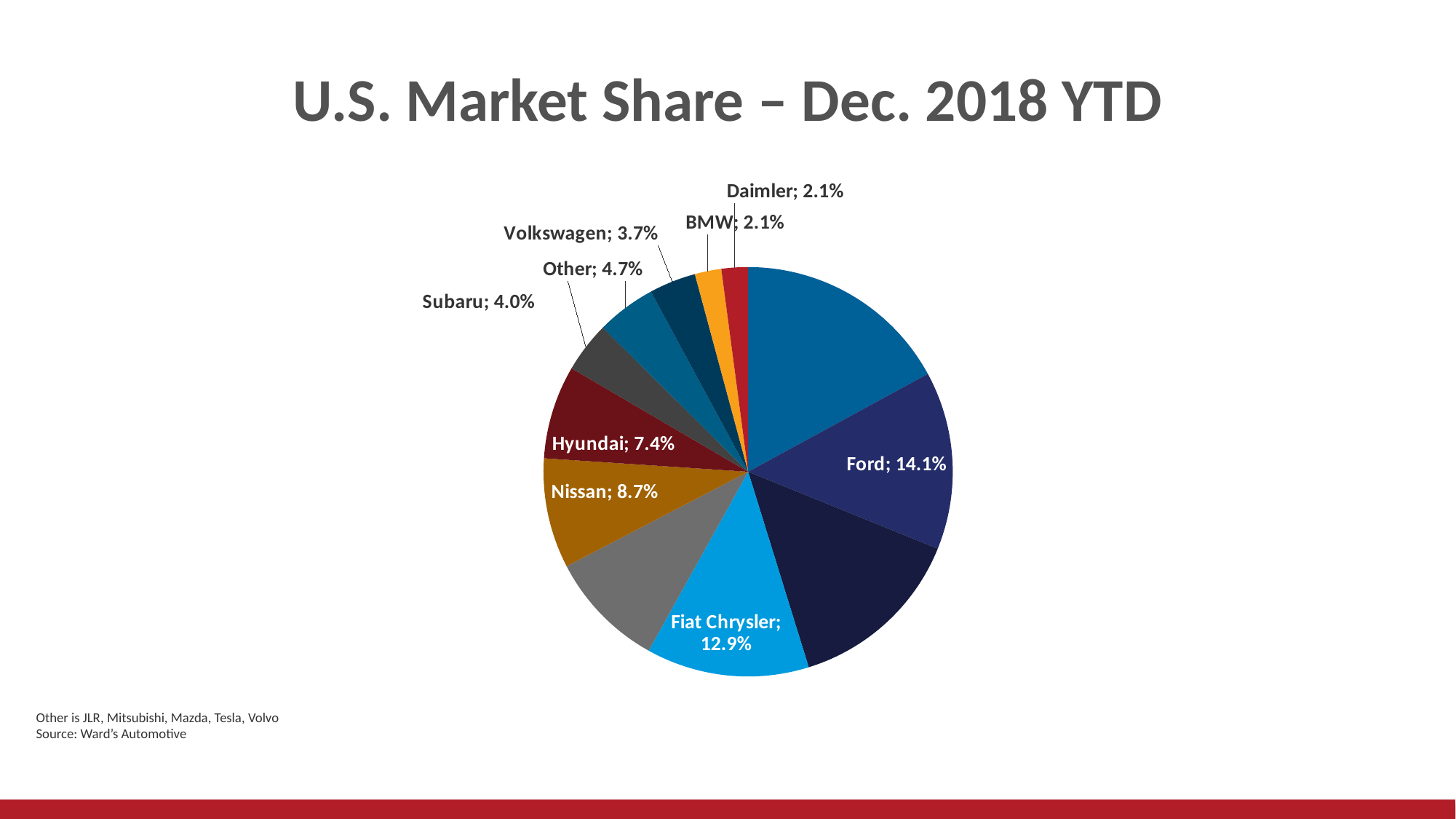
How many slices does the pie chart have? 12 What is the title of the chart? U.S. Market Share – Dec. 2018 YTD Which has the larger share, Ford or Fiat Chrysler? Ford What is Nissan's market share shown on the chart? 8.7% What share does Fiat Chrysler hold according to the chart? 12.9% How many percentage points larger is Nissan's share than Hyundai's? 1.3 Which has the larger share, Subaru or Volkswagen? Subaru What is Ford's share in the pie chart? 14.1% What is the share shown for Volkswagen? 3.7% What share is labeled for Hyundai? 7.4% What share is shown for Daimler? 2.1% What type of chart is shown on the slide? Pie chart